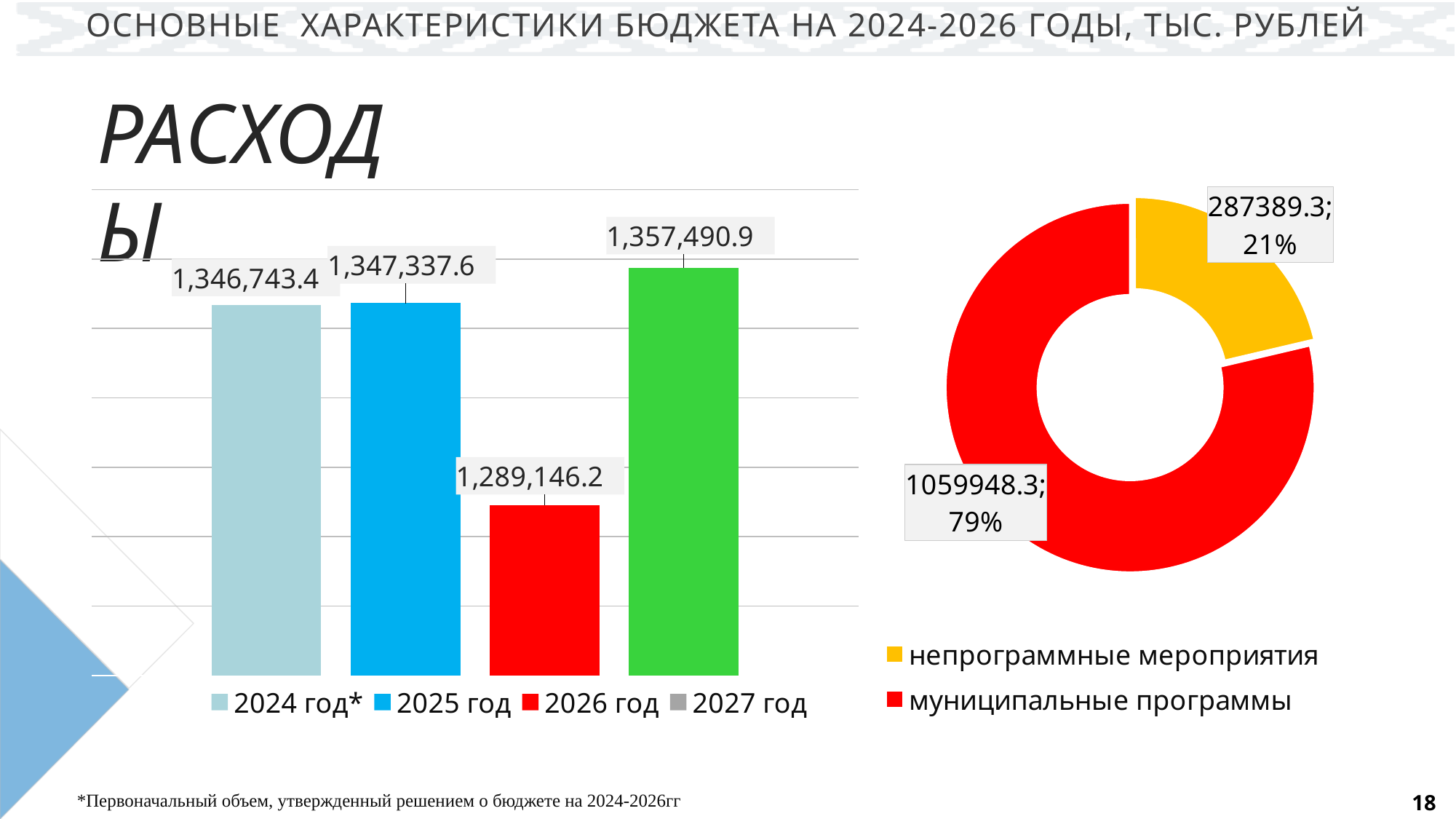
In the bar chart on the left, which is larger: the value for 2024 год* or the value for 2026 год? 2024 год* In the bar chart on the left, what is the difference between the values for 2025 год and 2026 год? 58,191.4 In the doughnut chart on the right, what is the value for муниципальные программы? 1059948.3 In the bar chart on the left, what is the value for 2026 год? 1,289,146.2 In the bar chart on the left, what is the value for 2024 год*? 1,346,743.4 In the doughnut chart on the right, what share does непрограммные мероприятия have? 21% In the bar chart on the left, what is the value for 2025 год? 1,347,337.6 In the bar chart on the left, which year has the lowest value? 2026 год In the bar chart on the left, which year has the highest value? 2027 год What kind of chart is the chart on the left of the slide? Bar chart How many series does the legend of the bar chart on the left list? 4 How many categories does the legend of the doughnut chart on the right list? 2